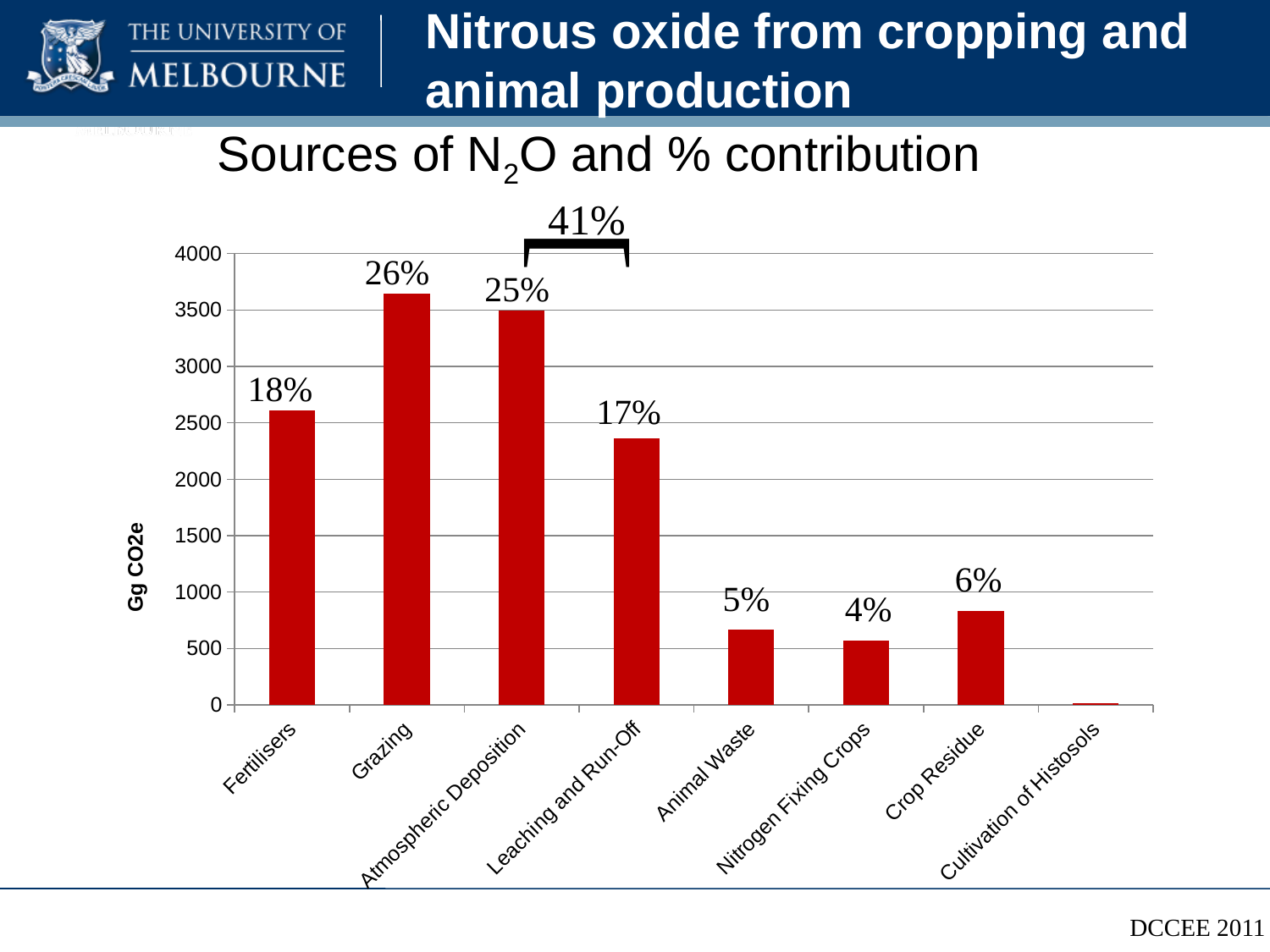
What kind of chart is shown on the slide? Bar chart What is the difference in percentage contribution between Grazing and Leaching and Run-Off? 9% Is the value for Animal Waste greater or less than 1000 Gg CO2e? less What percentage contribution is shown for Fertilisers? 18% Which has a larger percentage contribution, Crop Residue or Animal Waste? Crop Residue Which source has the lowest bar? Cultivation of Histosols What combined percentage is shown by the bracket over Atmospheric Deposition and Leaching and Run-Off? 41% What percentage contribution is shown for Grazing? 26% Which source has the highest bar? Grazing Is the value for Fertilisers greater or less than 2500 Gg CO2e? greater How many sources of N2O are shown on the x axis? 8 What percentage contribution is shown for Nitrogen Fixing Crops? 4%